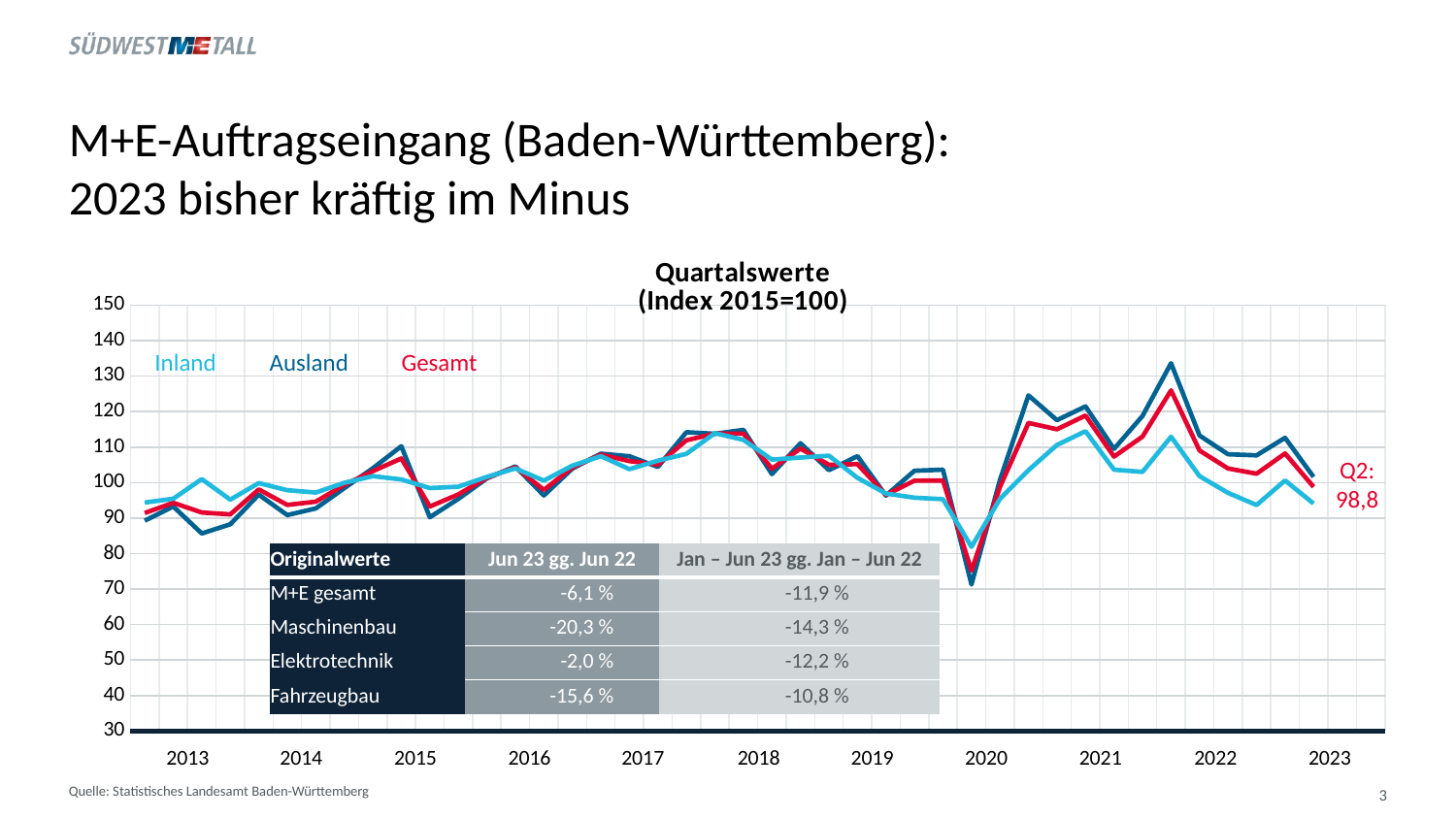
What is the labelled Q2 2023 value of the Gesamt series? 98,8 Is the lowest value of the Ausland series in 2020 greater or less than 80? less In the table, what is the value for M+E gesamt for Jun 23 gg. Jun 22? -6,1 % Is the lowest value of the Inland series in 2020 greater or less than 90? less How many series does the chart's legend list? 3 What is the title of the chart? Quartalswerte (Index 2015=100) At the peak in late 2021, which series is higher, Ausland or Inland? Ausland Is the peak value of the Ausland series in late 2021 greater or less than 130? greater Which colour is used for the Gesamt series? red In the table, which sector has the largest decline for Jun 23 gg. Jun 22? Maschinenbau What kind of chart is shown on the slide? line chart